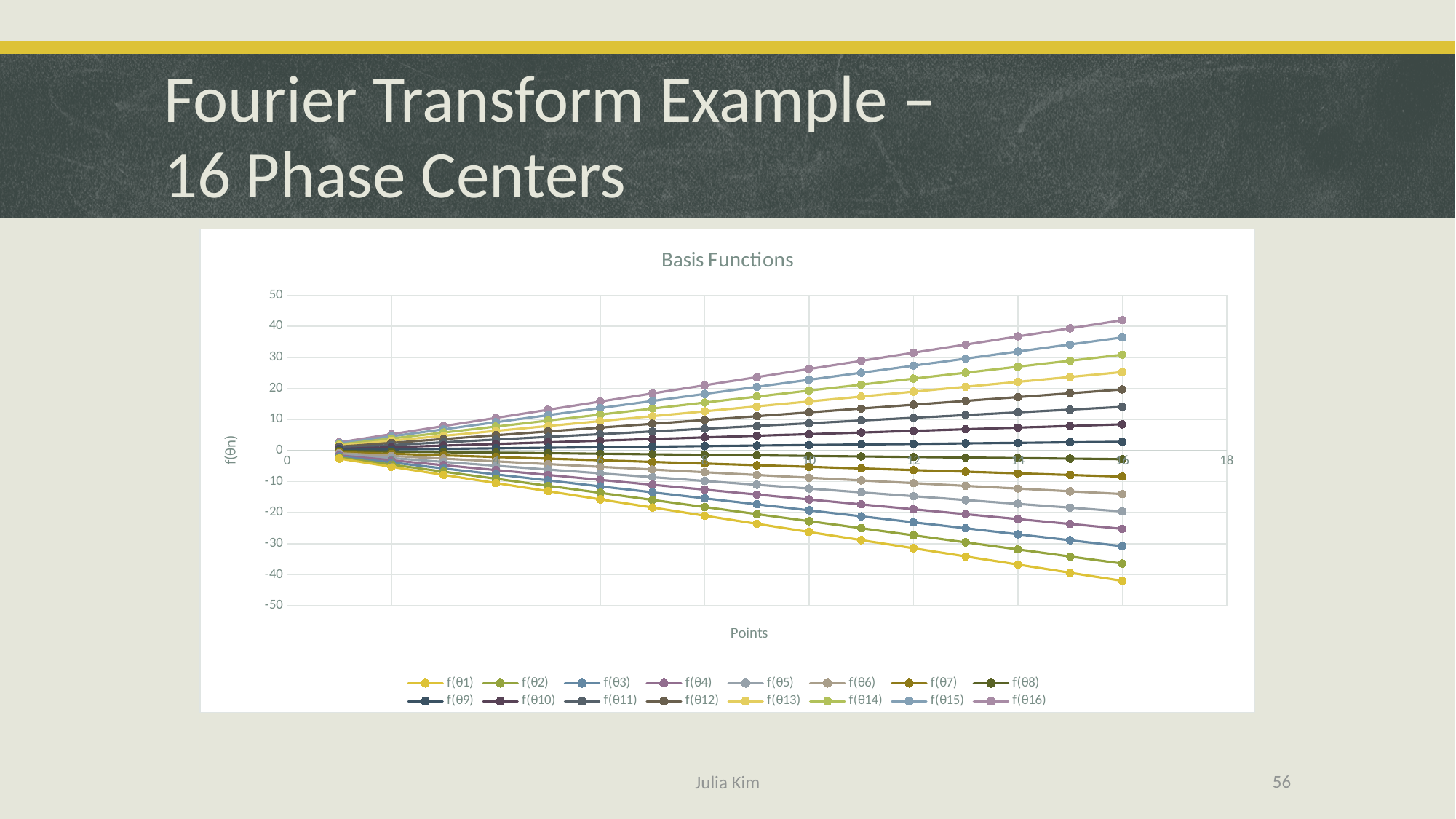
Is the value of f(θ15) at x = 16 greater or less than 30? greater What kind of chart is shown on the slide? Line chart Does the series f(θ16) rise or fall as x increases? rises What is the title of the chart? Basis Functions Which series has the lowest value at x = 16? f(θ1) Does the series f(θ1) rise or fall as x increases? falls Which series has the highest value at x = 16? f(θ16) How many series does the chart's legend list? 16 What is the label of the x axis? Points Is the value of f(θ16) at x = 16 greater or less than 40? greater Is the value of f(θ2) at x = 16 greater or less than -30? less